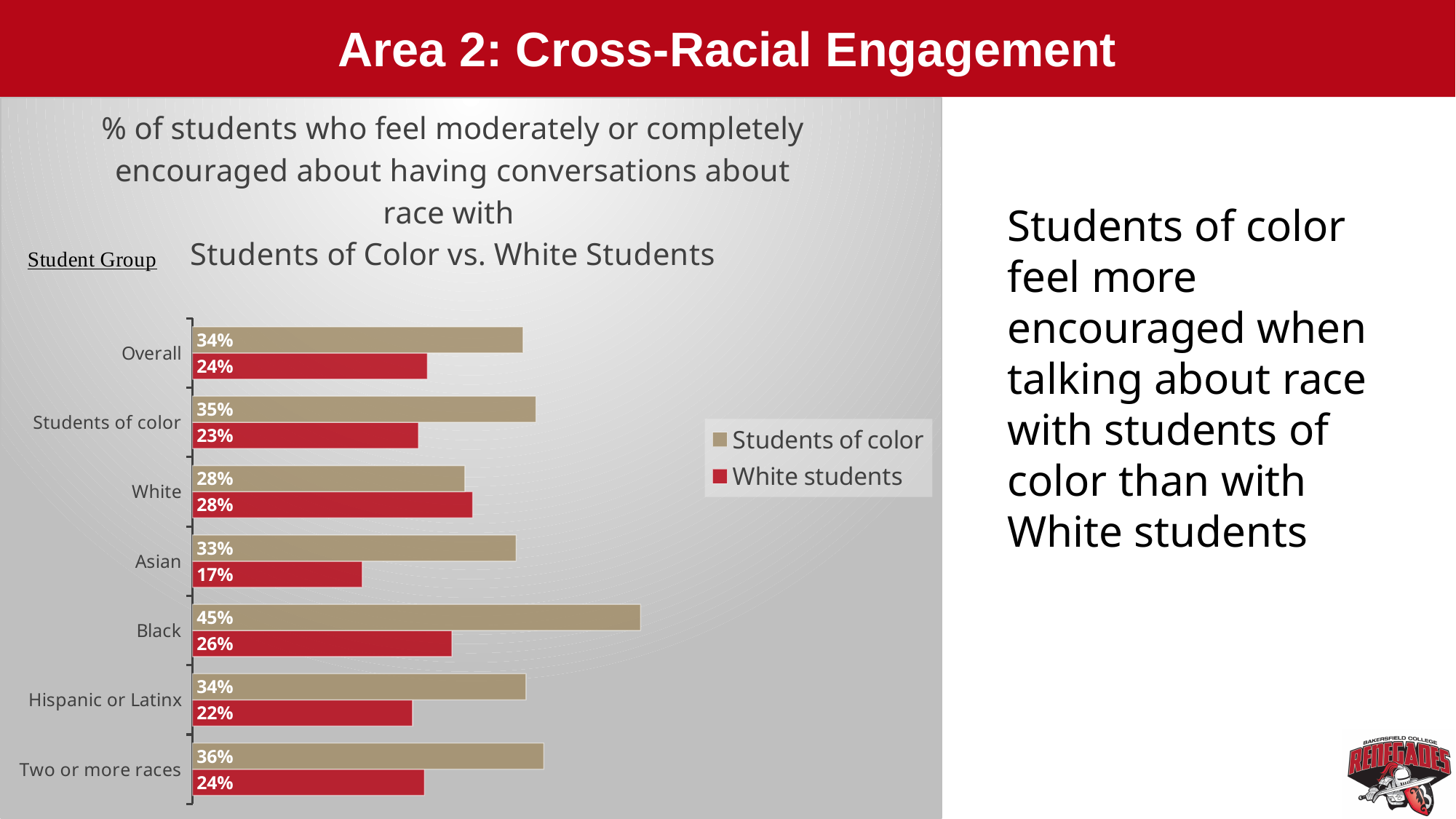
For Overall, which series has the larger value, Students of color or White students? Students of color What is the difference between the Students of color and White students values for Black? 19% What is the value for Black in the Students of color series? 45% How many student groups are shown on the chart? 7 What is the value for Asian in the White students series? 17% What colour are the bars for the White students series? Red What is the value for Hispanic or Latinx in the Students of color series? 34% How many series does the legend list? 2 What kind of chart is shown on the slide? Bar chart For which student group are the Students of color and White students values equal? White Which student group has the lowest value in the White students series? Asian Which student group has the highest value in the Students of color series? Black